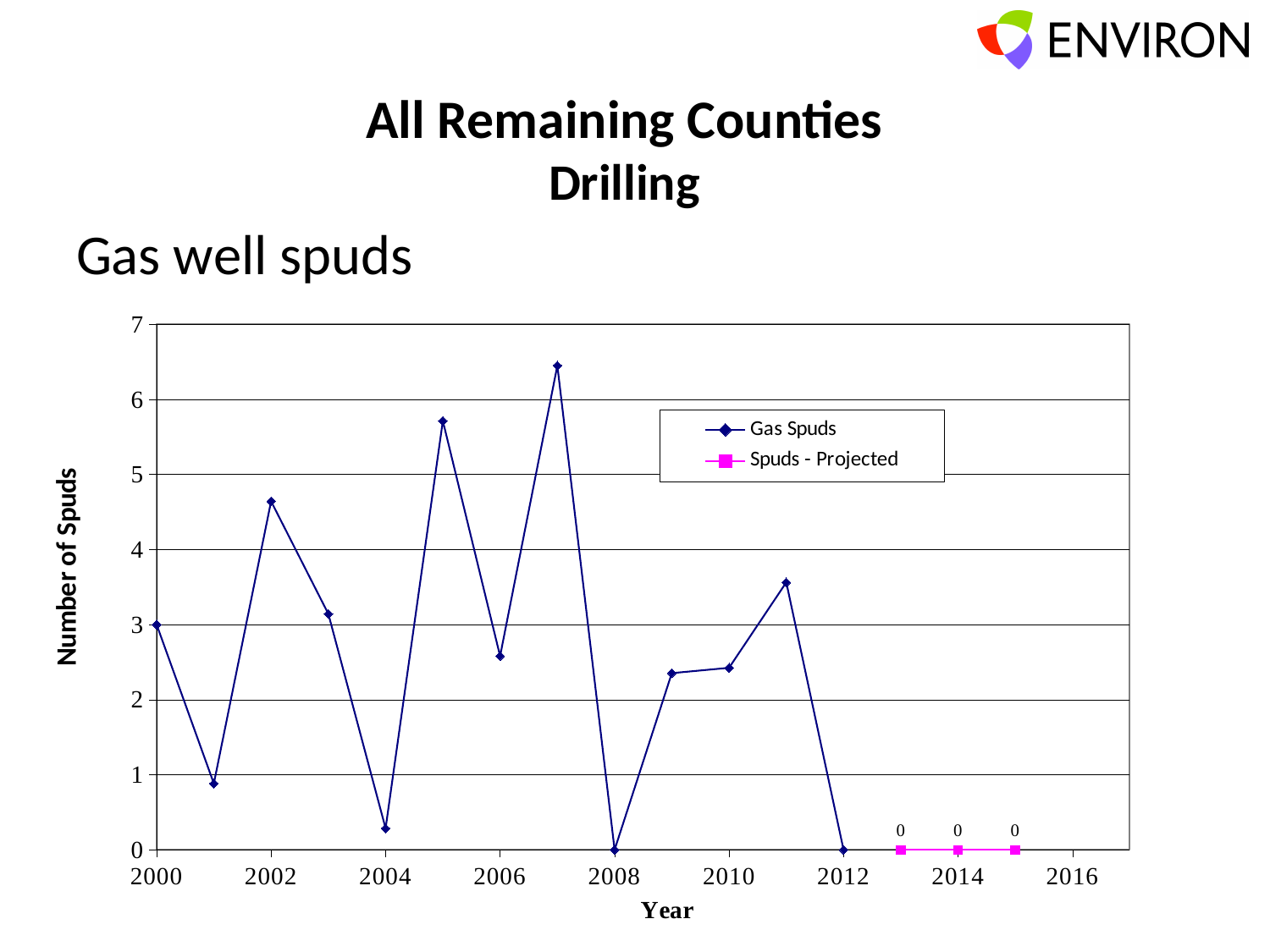
How many years are plotted for the Spuds - Projected series? 3 What is the projected number of spuds for 2014? 0 What type of chart is shown on the slide? line chart What is the title of the vertical axis? Number of Spuds What is the value of Gas Spuds in 2012? 0 Do the Gas Spuds values rise or fall from 2008 to 2011? rise What is the value of Gas Spuds in 2008? 0 Is the Gas Spuds value for 2004 greater or less than 1? less Which year has a higher Gas Spuds value, 2002 or 2005? 2005 In which year is the Gas Spuds value highest? 2007 How many series does the legend list? 2 Is the Gas Spuds value for 2007 greater or less than 6? greater